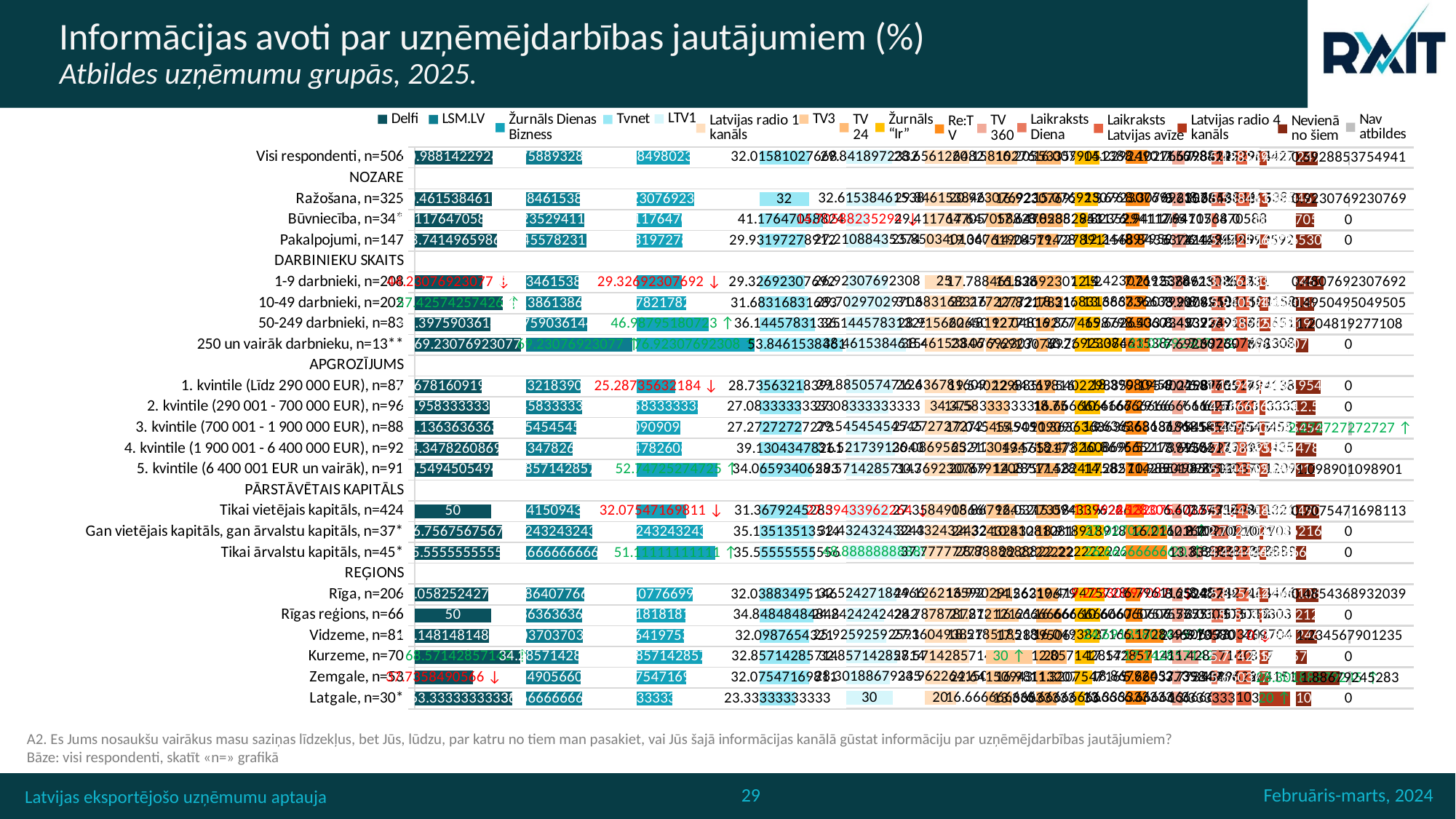
Which series is listed first in the chart legend? Delfi What is the title of the chart on the slide? Informācijas avoti par uzņēmējdarbības jautājumiem (%) What is the Delfi value for the group "Tikai vietējais kapitāls, n=424"? 50 What kind of chart is shown on the slide? bar chart How many respondent groups (bars) are plotted in the chart, excluding the section headings? 22 What is the Delfi value for the group "Rīgas reģions, n=66"? 50 How many series does the chart legend list? 16